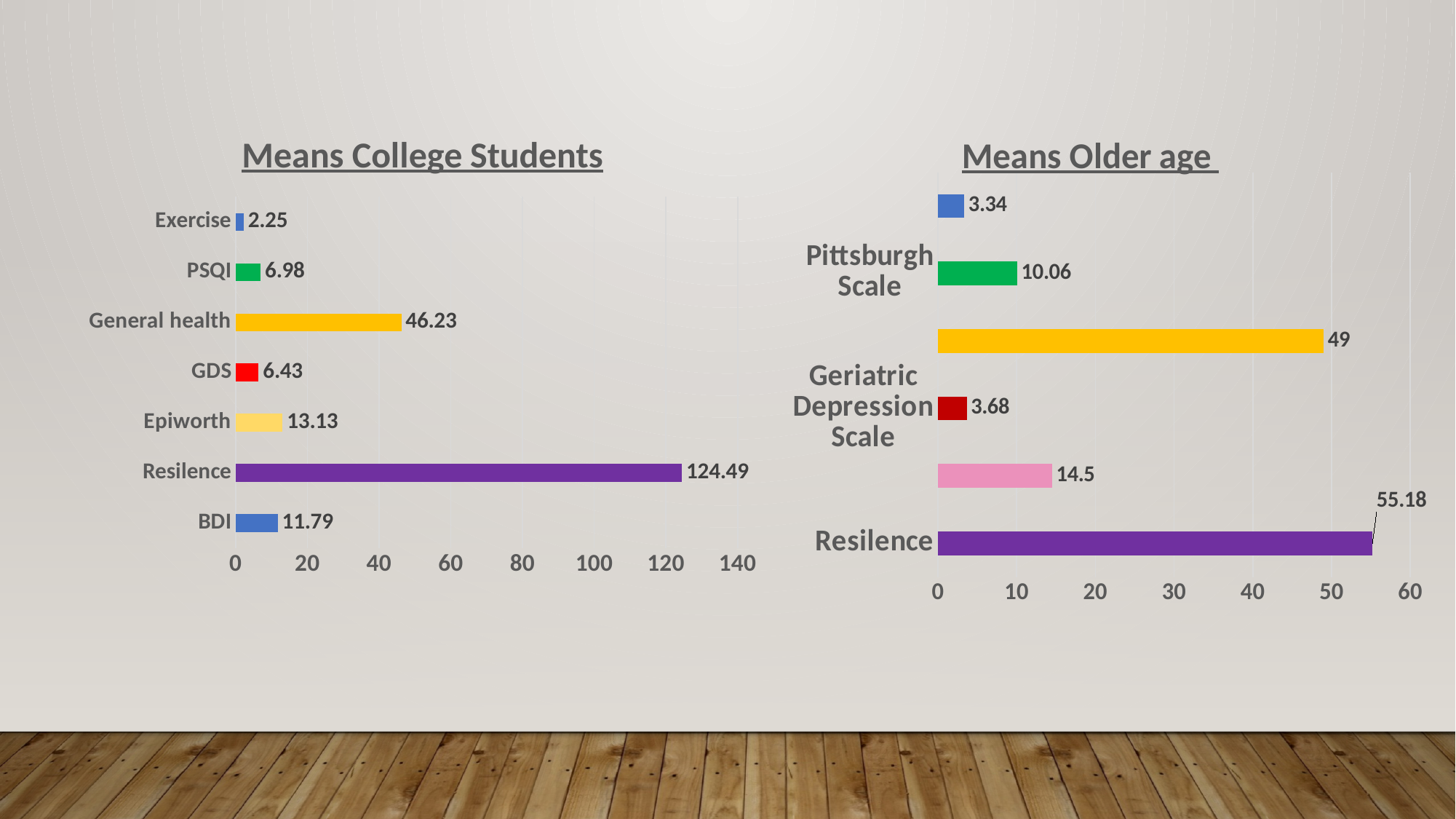
In the 'Means Older age' chart, what is the value for Resilence? 55.18 In the 'Means College Students' chart, what is the value for General health? 46.23 In the 'Means College Students' chart, which category has the highest value? Resilence In the 'Means Older age' chart, is the value for Resilence greater or less than 50? greater In the 'Means College Students' chart, what is the difference between the values for Epiworth and GDS? 6.7 What kind of chart is the 'Means Older age' chart? bar chart In the 'Means College Students' chart, how many categories are shown? 7 In the 'Means College Students' chart, which is larger, the value for PSQI or the value for GDS? PSQI In the 'Means College Students' chart, what is the value for BDI? 11.79 In the 'Means College Students' chart, which category has the lowest value? Exercise In the 'Means Older age' chart, what is the value for Geriatric Depression Scale? 3.68 In the 'Means Older age' chart, what is the value for Pittsburgh Scale? 10.06